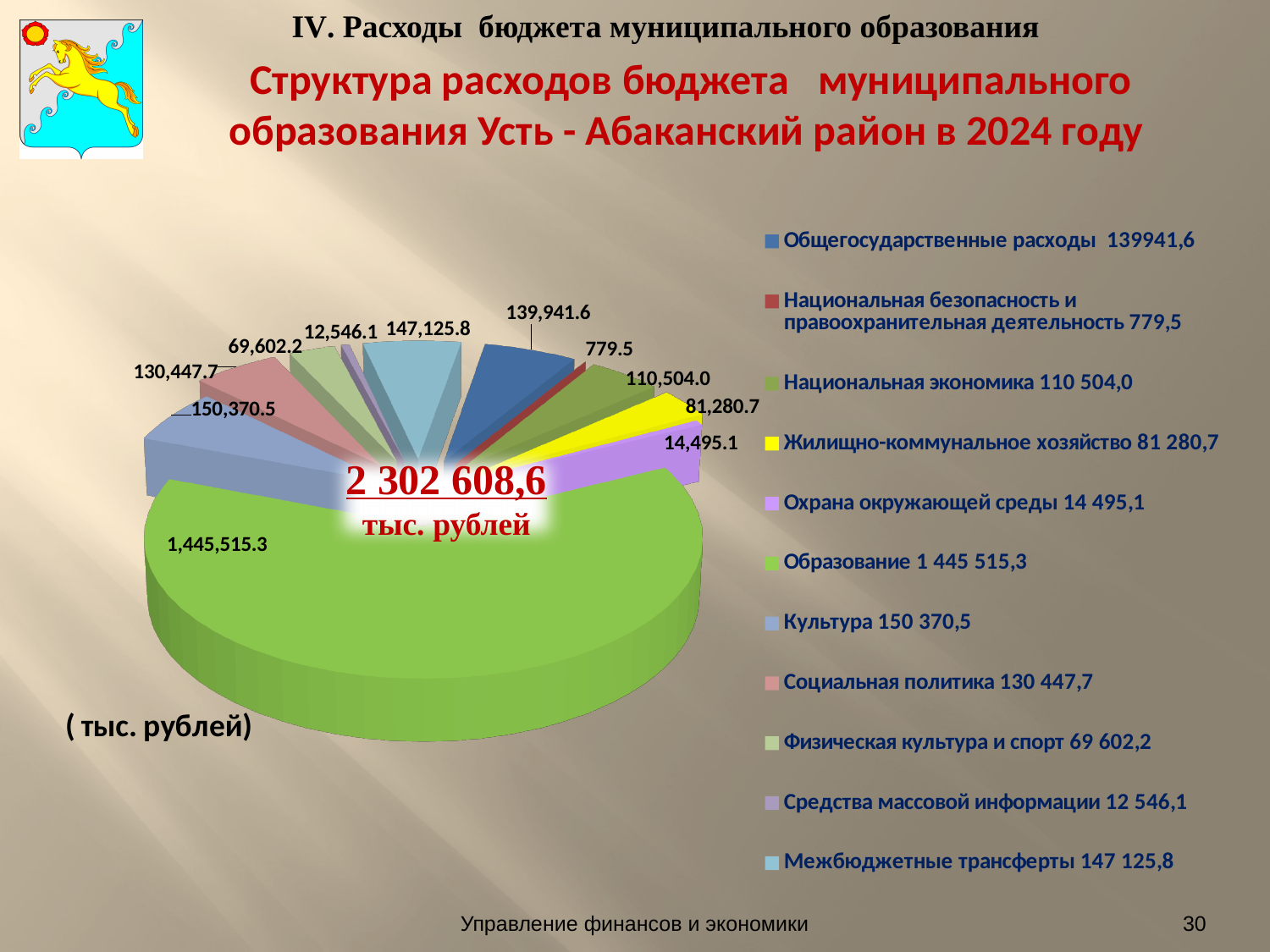
What type of chart is shown on the slide? pie chart What is the value for Жилищно-коммунальное хозяйство? 81,280.7 What total amount is printed in the centre of the pie chart? 2 302 608,6 тыс. рублей What is the value for Общегосударственные расходы? 139,941.6 What is the value for Образование? 1,445,515.3 What is the value for Межбюджетные трансферты? 147,125.8 What is the difference between the values for Национальная экономика and Жилищно-коммунальное хозяйство? 29,223.3 Which category has the smallest slice of the pie? Национальная безопасность и правоохранительная деятельность What is the difference between the values for Культура and Социальная политика? 19,922.8 Which is larger, the value for Межбюджетные трансферты or the value for Общегосударственные расходы? Межбюджетные трансферты Which category has the largest slice of the pie? Образование How many categories are shown in the pie chart? 11